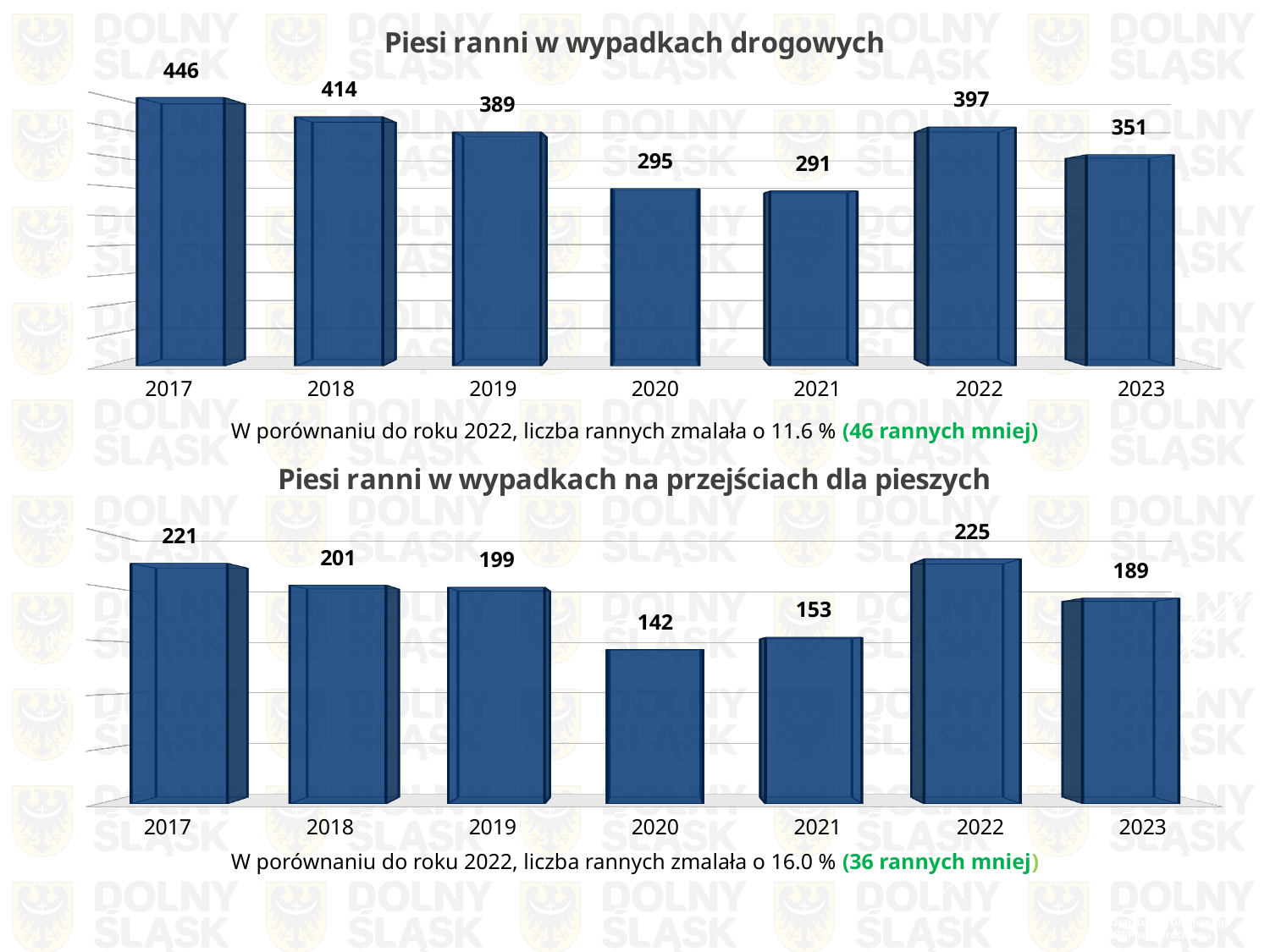
In the chart 'Piesi ranni w wypadkach na przejściach dla pieszych', which year has the highest value? 2022 In the chart 'Piesi ranni w wypadkach drogowych', what is the value for 2017? 446 What is the title of the bottom chart on the slide? Piesi ranni w wypadkach na przejściach dla pieszych In the chart 'Piesi ranni w wypadkach drogowych', how many years are shown on the x axis? 7 In the chart 'Piesi ranni w wypadkach drogowych', which year has the lowest value? 2021 In the chart 'Piesi ranni w wypadkach na przejściach dla pieszych', which is larger, the value for 2020 or the value for 2021? 2021 In the chart 'Piesi ranni w wypadkach drogowych', what is the difference between the values for 2022 and 2023? 46 In the chart 'Piesi ranni w wypadkach na przejściach dla pieszych', what is the difference between the values for 2022 and 2023? 36 What kind of chart is the top chart on the slide? bar chart In the chart 'Piesi ranni w wypadkach na przejściach dla pieszych', what is the value for 2020? 142 In the chart 'Piesi ranni w wypadkach drogowych', do the values rise or fall from 2017 to 2021? fall In the chart 'Piesi ranni w wypadkach drogowych', which is larger, the value for 2018 or the value for 2022? 2018